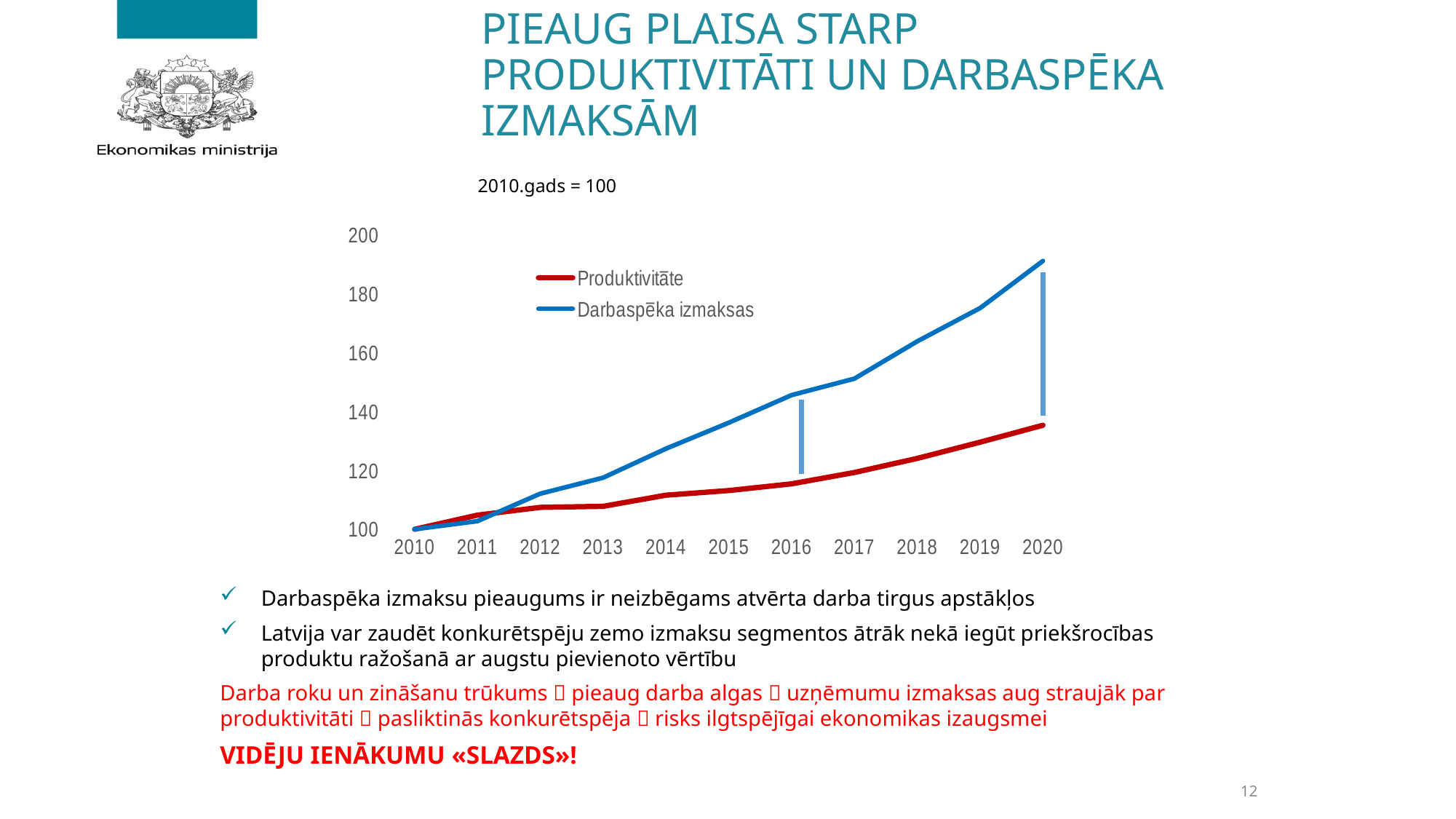
How many years are shown on the x axis of the chart? 11 What colour is the Darbaspēka izmaksas line? blue In which year does the Darbaspēka izmaksas series reach its highest value? 2020 What is the value of both series in 2010? 100 Is the value for Darbaspēka izmaksas in 2016 greater or less than 140? greater Is the value for Darbaspēka izmaksas in 2020 greater or less than 180? greater What kind of chart is shown on the slide? line chart Is the value for Produktivitāte in 2020 greater or less than 140? less Which two series are listed in the chart legend? Produktivitāte and Darbaspēka izmaksas How many series does the chart legend list? 2 Which series has the higher value in 2020? Darbaspēka izmaksas Does the Darbaspēka izmaksas line rise or fall from 2010 to 2020? rise